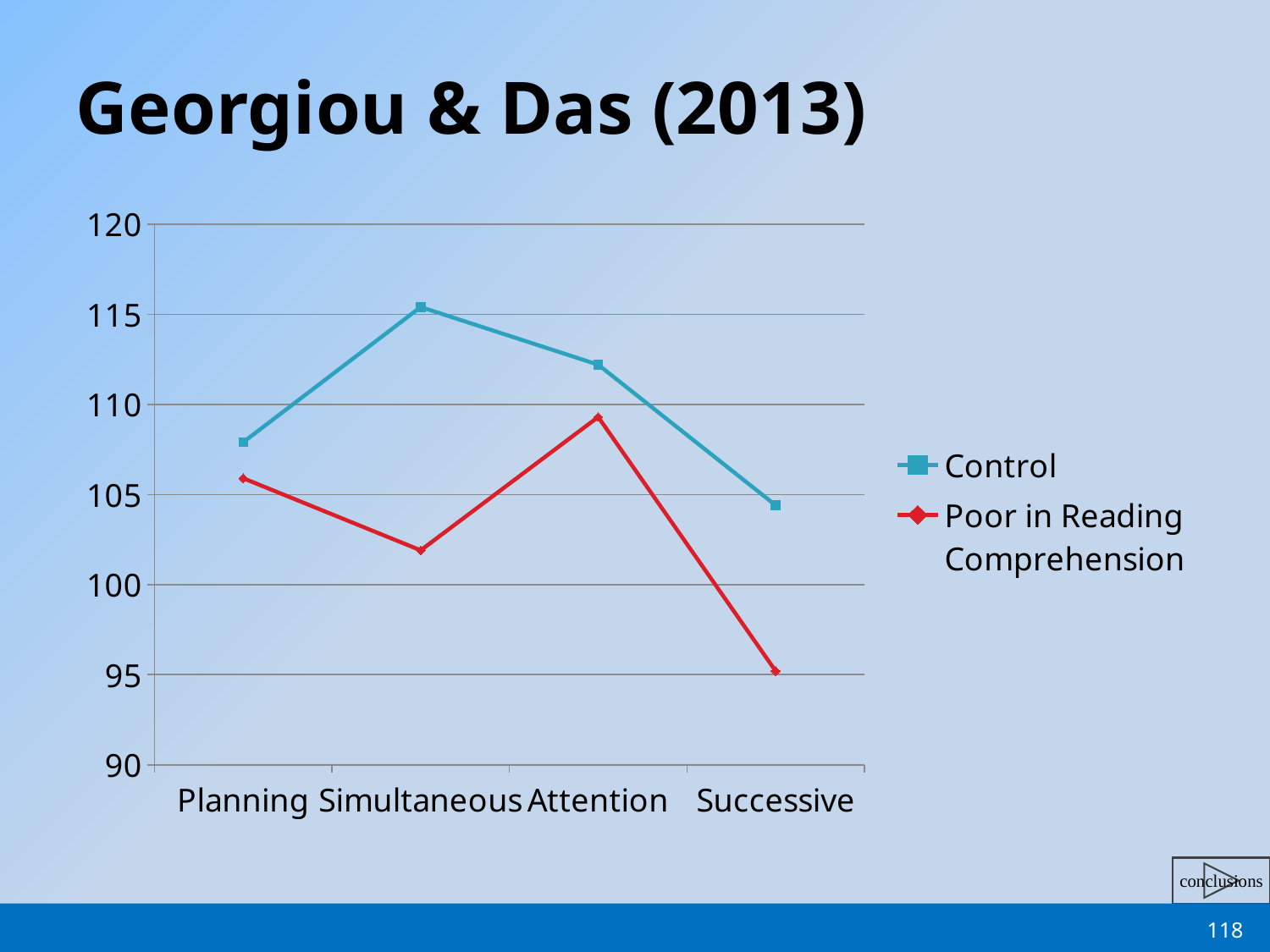
How many categories are shown on the x axis? 4 Which series has the larger value for Simultaneous, Control or Poor in Reading Comprehension? Control For which category is the Poor in Reading Comprehension series lowest? Successive For which category is the Poor in Reading Comprehension series highest? Attention For which category is the Control series highest? Simultaneous How many series does the legend list? 2 Does the Poor in Reading Comprehension series rise or fall from Attention to Successive? fall Is the Control value for Attention greater or less than 110? greater Is the Poor in Reading Comprehension value for Successive greater or less than 100? less Is the Control value for Planning greater or less than 105? greater What kind of chart is shown on the slide? line chart What is the title of the slide containing the chart? Georgiou & Das (2013)